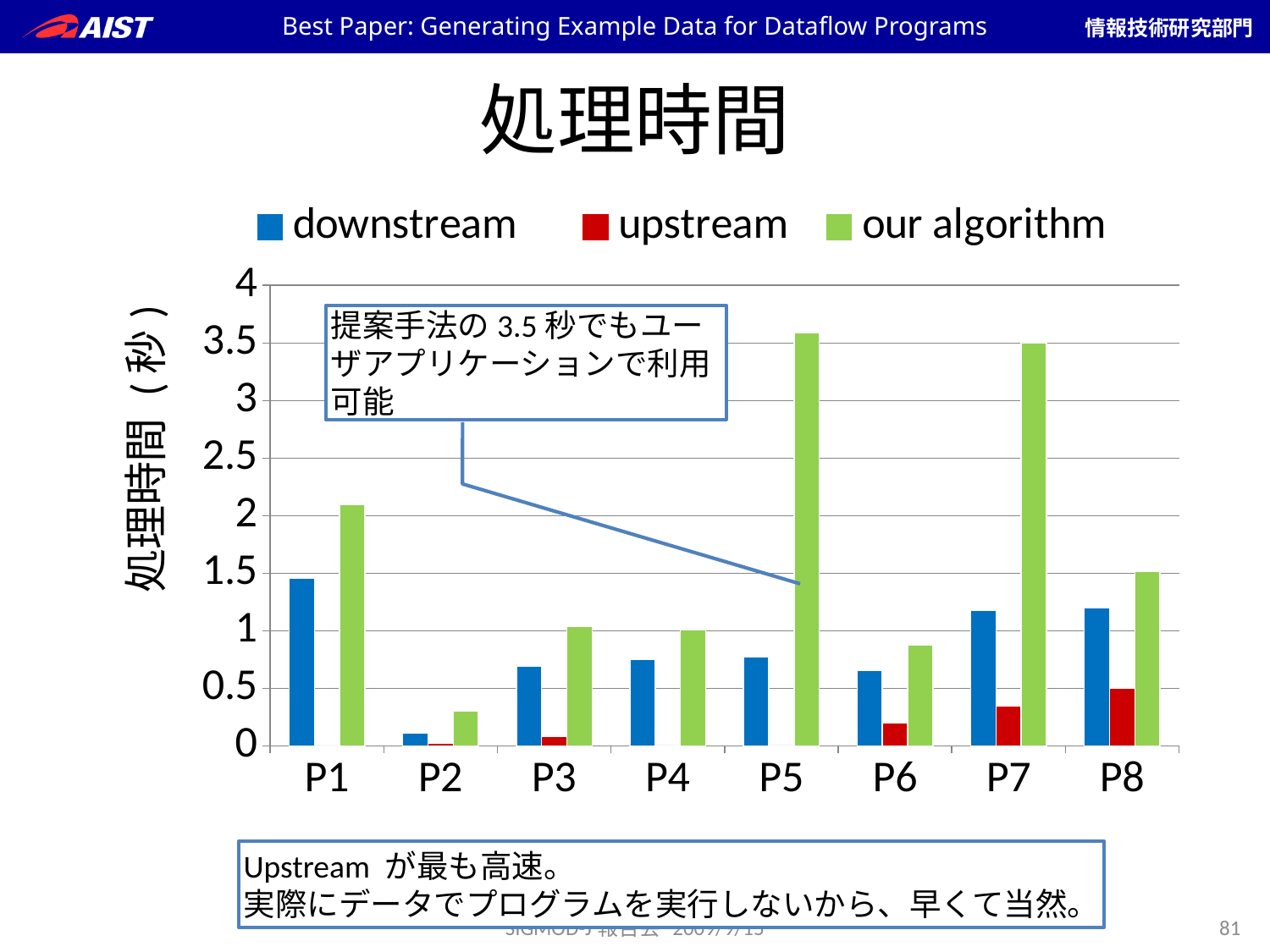
Is the 'our algorithm' value for P1 greater or less than 2? greater Which colour represents the 'upstream' series in the legend? red What kind of chart is shown on the slide? bar chart Is the 'downstream' value for P2 greater or less than 0.5? less How many categories are shown on the x axis? 8 Is the 'our algorithm' value for P5 greater or less than 3? greater For P8, which is larger: the 'upstream' value or the 'downstream' value? downstream For P1, which is larger: the 'downstream' value or the 'our algorithm' value? our algorithm How many series does the legend list? 3 Which category has the lowest value for the 'our algorithm' series? P2 Which category has the highest value for the 'downstream' series? P1